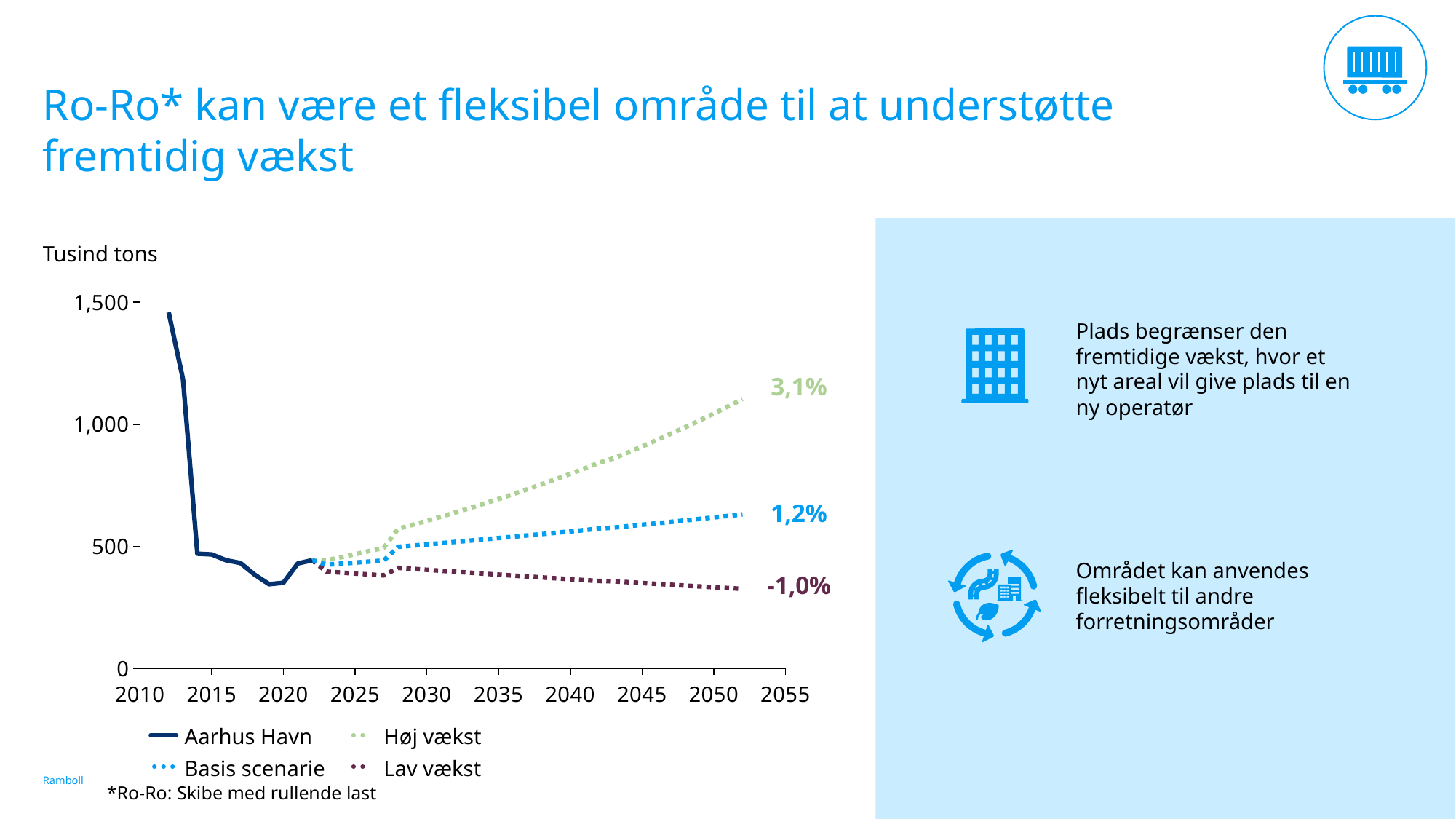
What unit is shown above the y axis of the chart? Tusind tons What annual growth rate is printed next to the Høj vækst line? 3,1% Is the value of the Høj vækst line at its end point (around 2052) greater or less than 1,000? greater How many series does the chart legend list? 4 At the end of the projection (around 2052), which line is higher: Høj vækst or Lav vækst? Høj vækst Does the Aarhus Havn line rise or fall between 2012 and 2014? fall Is the value of the Lav vækst line at its end point (around 2052) greater or less than 500? less What annual growth rate is printed next to the Basis scenarie line? 1,2% What kind of chart is shown on the slide? line chart Does the Lav vækst line rise or fall from 2022 to 2052? fall What annual growth rate is printed next to the Lav vækst line? -1,0% Is the first value of the Aarhus Havn line (around 2012) greater or less than 1,000? greater